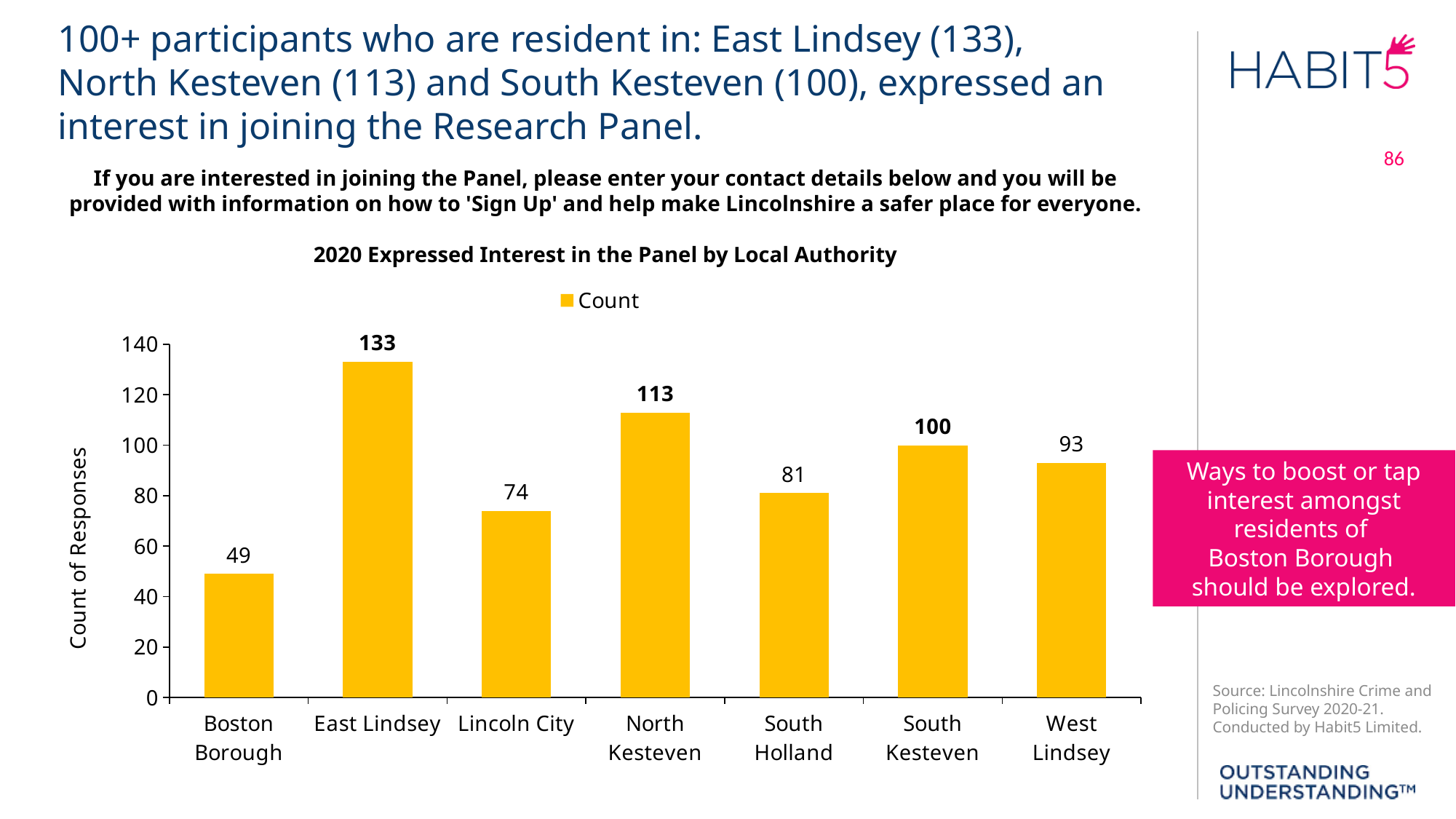
What is the count of responses for Boston Borough? 49 How many series does the legend list? 1 What is the count of responses for West Lindsey? 93 Which has a higher count of responses, Lincoln City or South Holland? South Holland What is the count of responses for East Lindsey? 133 Which local authority has the highest count of responses? East Lindsey What kind of chart is shown on the slide? Bar chart How many local authorities are shown on the chart? 7 Is the value for West Lindsey greater or less than 100? less What is the title of the chart? 2020 Expressed Interest in the Panel by Local Authority Which local authority has the lowest count of responses? Boston Borough What is the difference between the counts for North Kesteven and South Kesteven? 13